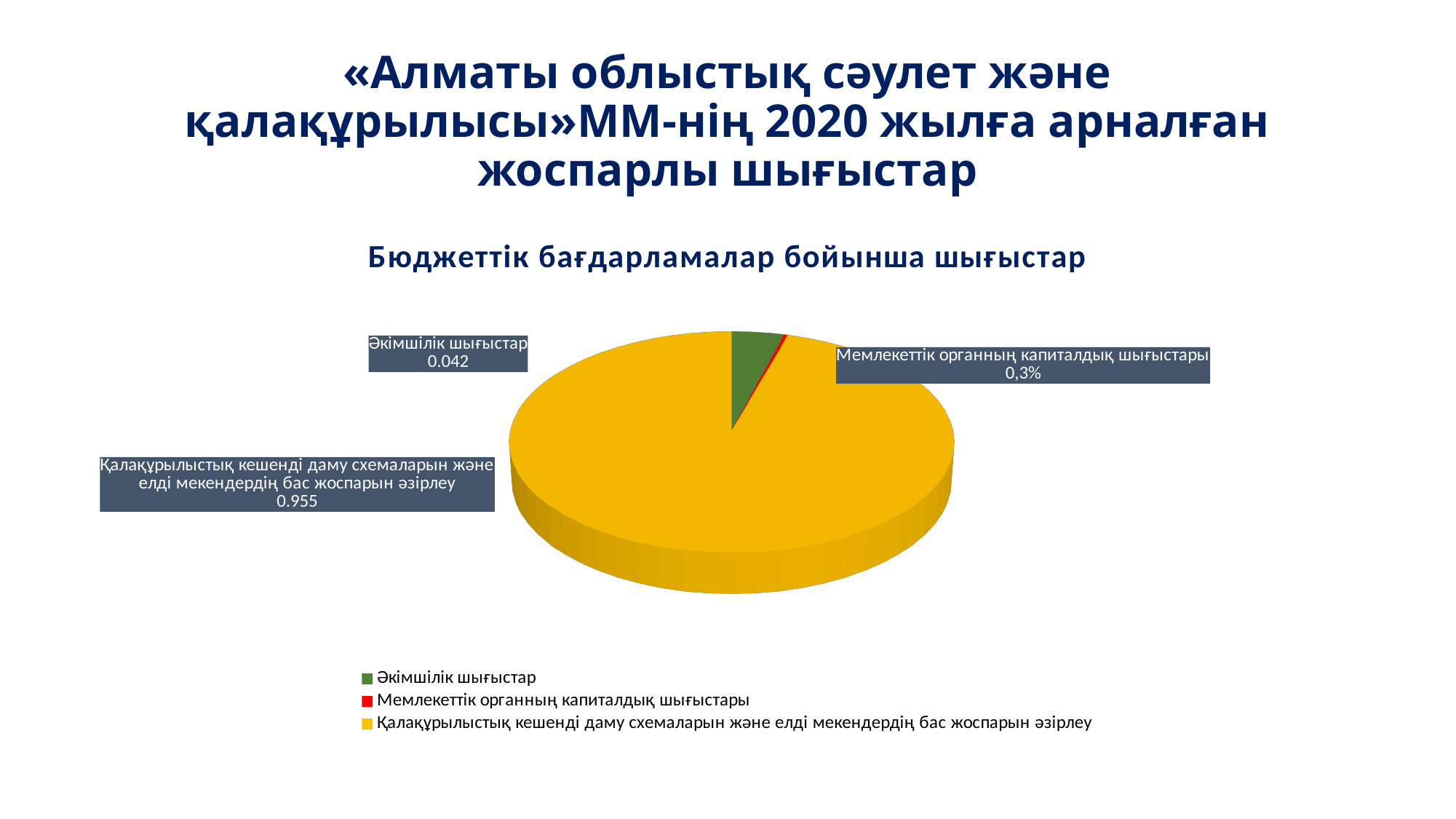
What is the chart's title? Бюджеттік бағдарламалар бойынша шығыстар How many slices does the pie chart have? 3 Which category has the smallest slice of the pie? Мемлекеттік органның капиталдық шығыстары Which is larger: the slice for Әкімшілік шығыстар or the slice for Мемлекеттік органның капиталдық шығыстары? Әкімшілік шығыстар What value is shown for Әкімшілік шығыстар? 0.042 How many entries does the legend list? 3 What kind of chart is shown on the slide? pie chart What value is shown for Мемлекеттік органның капиталдық шығыстары? 0,3% What colour is the slice for Әкімшілік шығыстар? green What value is shown for Қалақұрылыстық кешенді даму схемаларын және елді мекендердің бас жоспарын әзірлеу? 0.955 What is the difference between the values for Қалақұрылыстық кешенді даму схемаларын және елді мекендердің бас жоспарын әзірлеу and Әкімшілік шығыстар? 0.913 Which category has the largest slice of the pie? Қалақұрылыстық кешенді даму схемаларын және елді мекендердің бас жоспарын әзірлеу